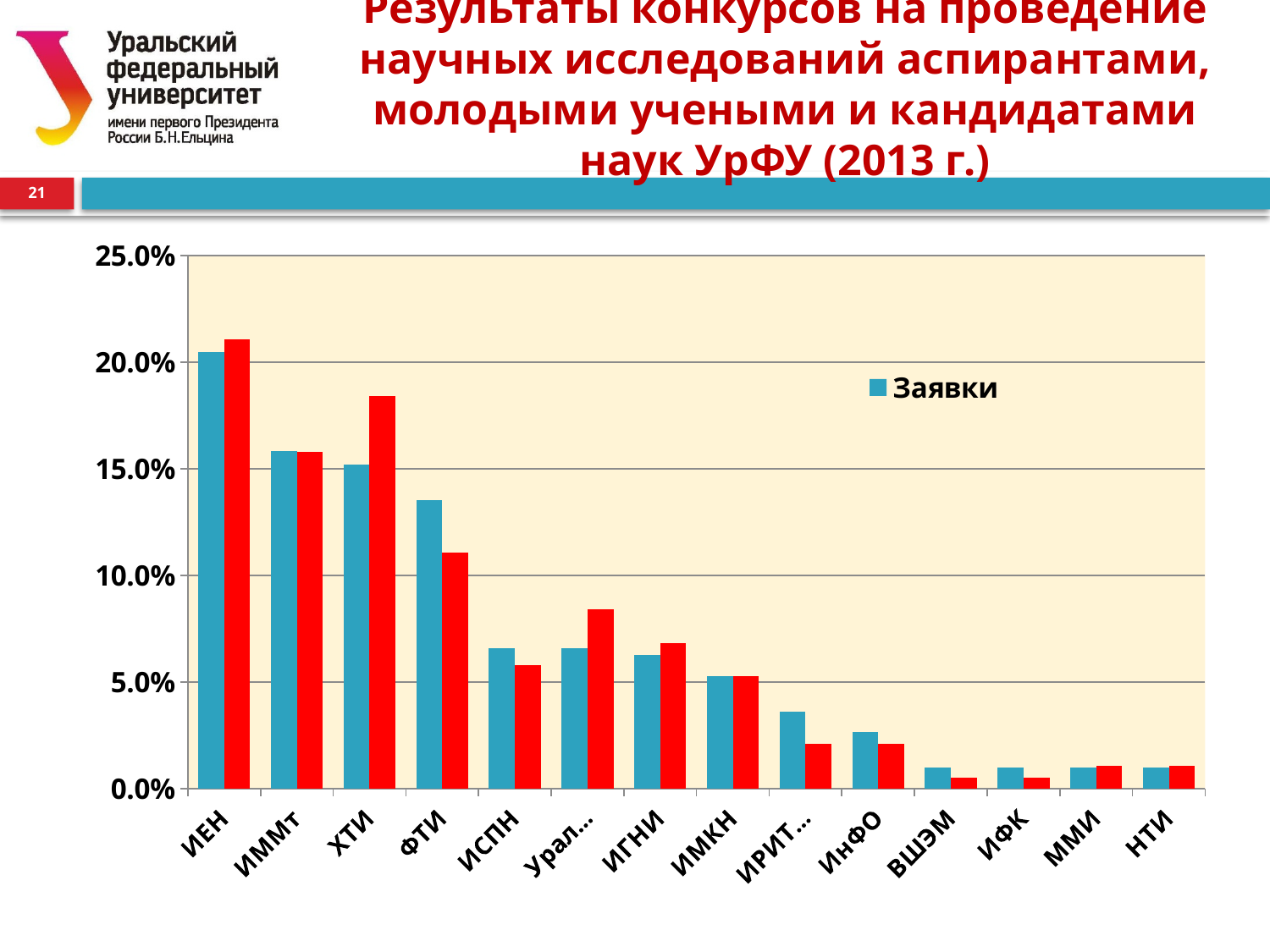
How many categories are shown along the x axis of the chart? 14 Which has the larger value for Заявки, ФТИ or ИСПН? ФТИ Is the value for Заявки for ИСПН greater or less than 10%? less What kind of chart is shown on the slide? bar chart Is the value for Заявки for ФТИ greater or less than 10%? greater Is the value for Заявки for ИЕН greater or less than 15%? greater What series name is shown in the chart's legend? Заявки Which has the larger value for Заявки, ИЕН or ИММт? ИЕН Do the Заявки values generally rise or fall from left to right along the x axis? fall How many series does the chart's legend list? 1 Which category has the highest value for Заявки? ИЕН